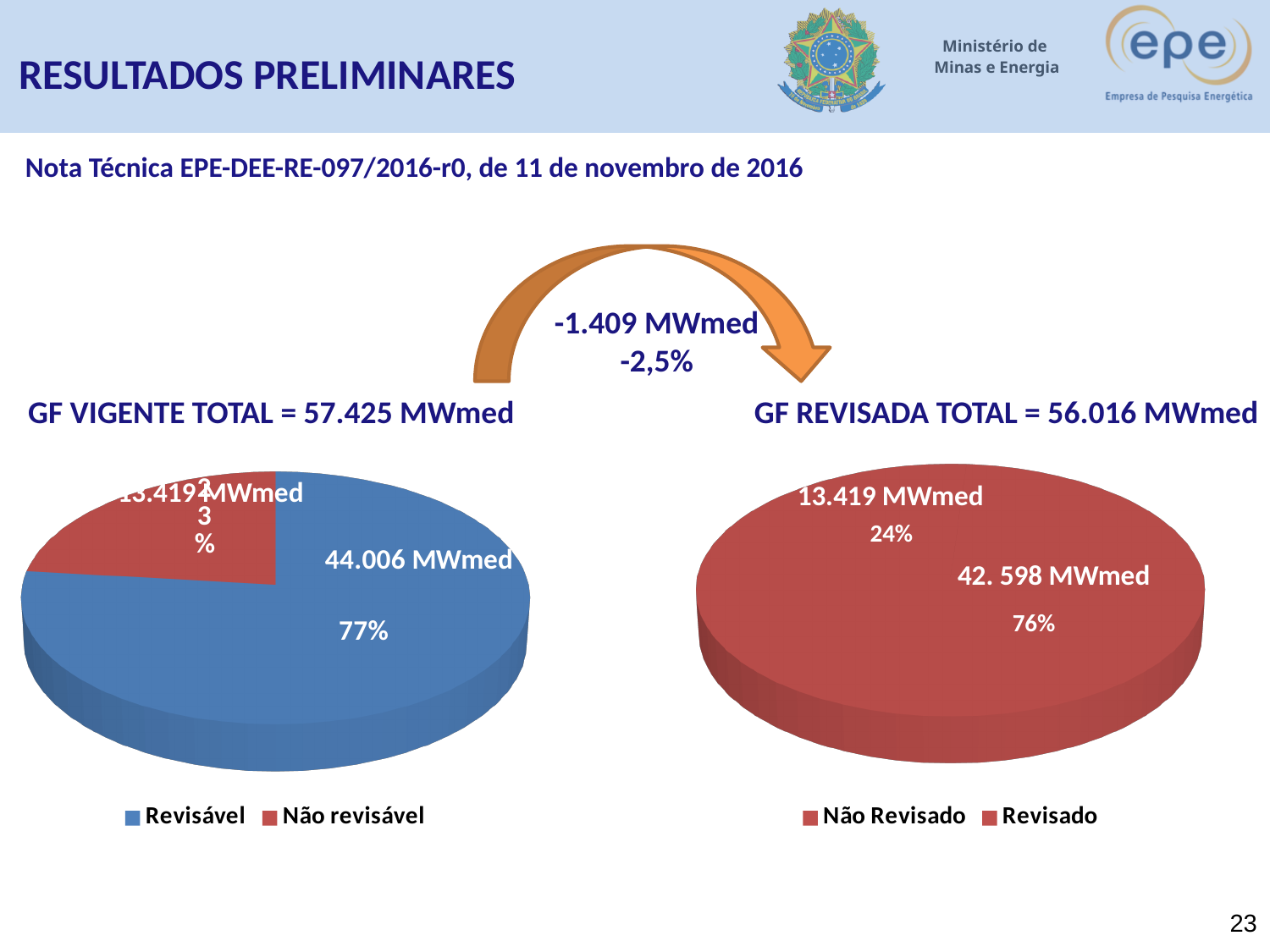
In the GF VIGENTE TOTAL chart on the left, what share of the pie does Revisável represent? 77% In the GF VIGENTE TOTAL chart on the left, which slice is larger, Revisável or Não revisável? Revisável What kind of chart is the GF REVISADA TOTAL chart on the right? pie chart How many slices does the GF REVISADA TOTAL chart on the right have? 2 What are the legend entries of the GF VIGENTE TOTAL chart on the left? Revisável, Não revisável In the GF VIGENTE TOTAL chart on the left, what is the value for Não revisável? 13.419 MWmed In the GF VIGENTE TOTAL chart on the left, what is the value for Revisável? 44.006 MWmed What kind of chart is the GF VIGENTE TOTAL chart on the left? pie chart